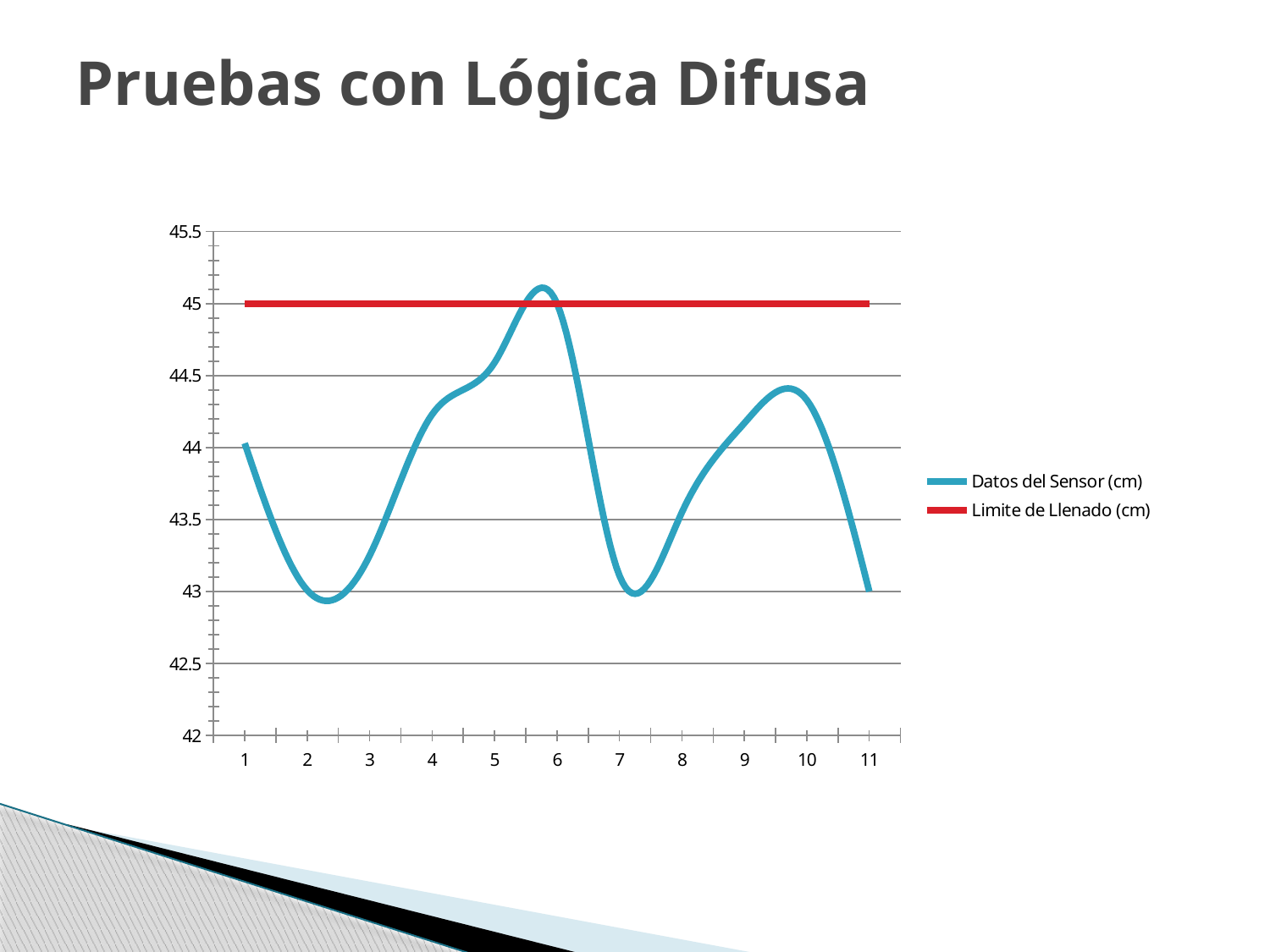
Is the value of Datos del Sensor (cm) at x = 4 greater or less than 44? greater What is the value of Limite de Llenado (cm) at x = 5? 45 Is the value of Datos del Sensor (cm) at x = 7 greater or less than 43.5? less Is the value of Datos del Sensor (cm) at x = 10 greater or less than 44? greater Does Datos del Sensor (cm) rise or fall from x = 7 to x = 10? rise How many series does the legend list? 2 How many points are labelled along the x axis? 11 Does Datos del Sensor (cm) rise or fall from x = 1 to x = 2? fall What colour is the Limite de Llenado (cm) line? red What kind of chart is shown on the slide? line chart Which is larger for Datos del Sensor (cm): the value at x = 4 or at x = 2? x = 4